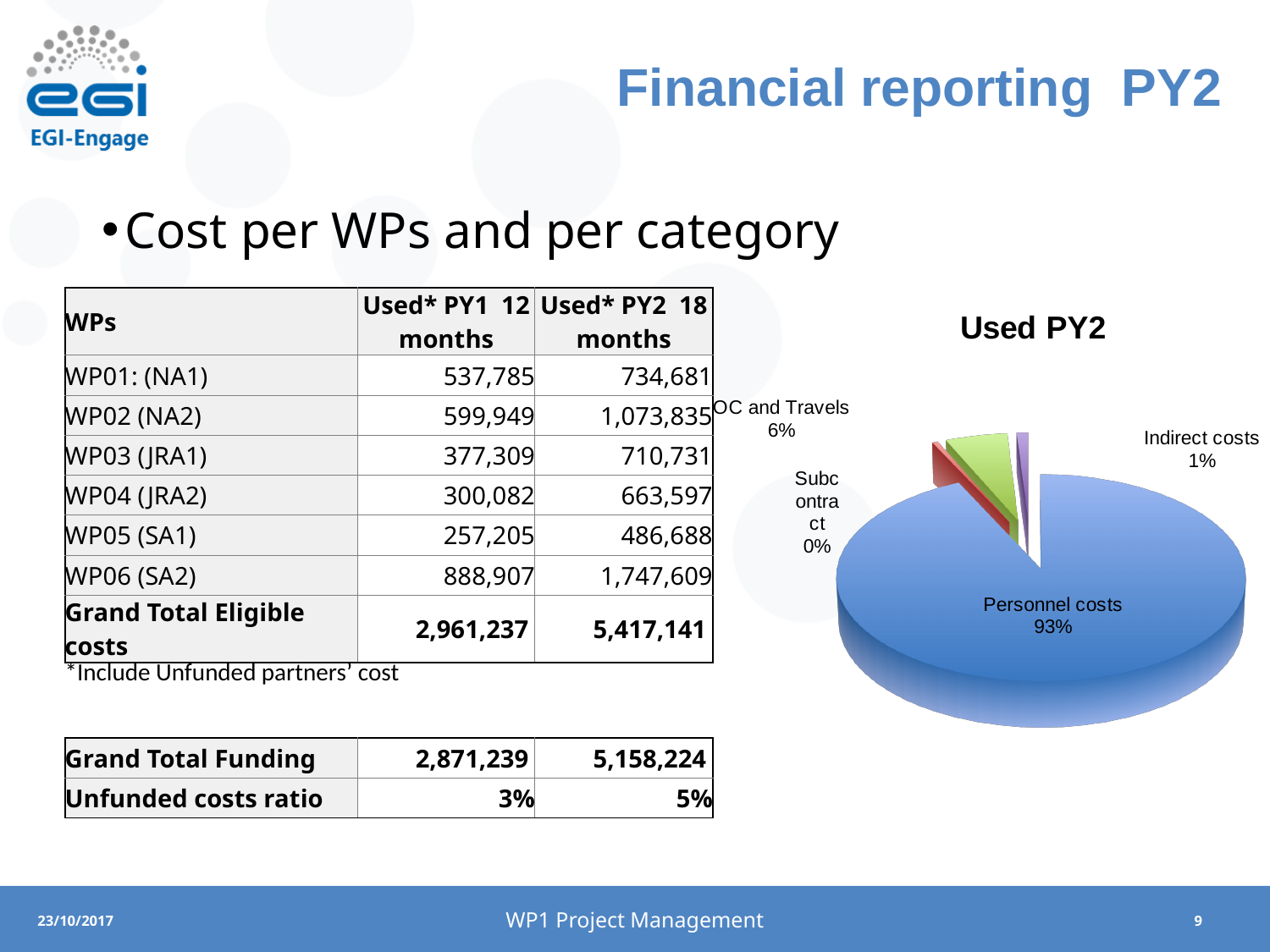
Which category has the smallest slice in the "Used PY2" pie chart? Subcontract In the "Used PY2" pie chart, what colour is the Personnel costs slice? blue In the "Used PY2" pie chart, which is larger: OC and Travels or Indirect costs? OC and Travels In the "Used PY2" pie chart, what share is labelled for Subcontract? 0% In the "Used PY2" pie chart, what share is labelled for OC and Travels? 6% What is the title of the pie chart on the slide? Used PY2 Which category has the largest slice in the "Used PY2" pie chart? Personnel costs In the "Used PY2" pie chart, what share is labelled for Personnel costs? 93% In the "Used PY2" pie chart, what is the difference in percentage points between Personnel costs and OC and Travels? 87 What kind of chart is the "Used PY2" chart? pie chart How many categories are shown in the "Used PY2" pie chart? 4